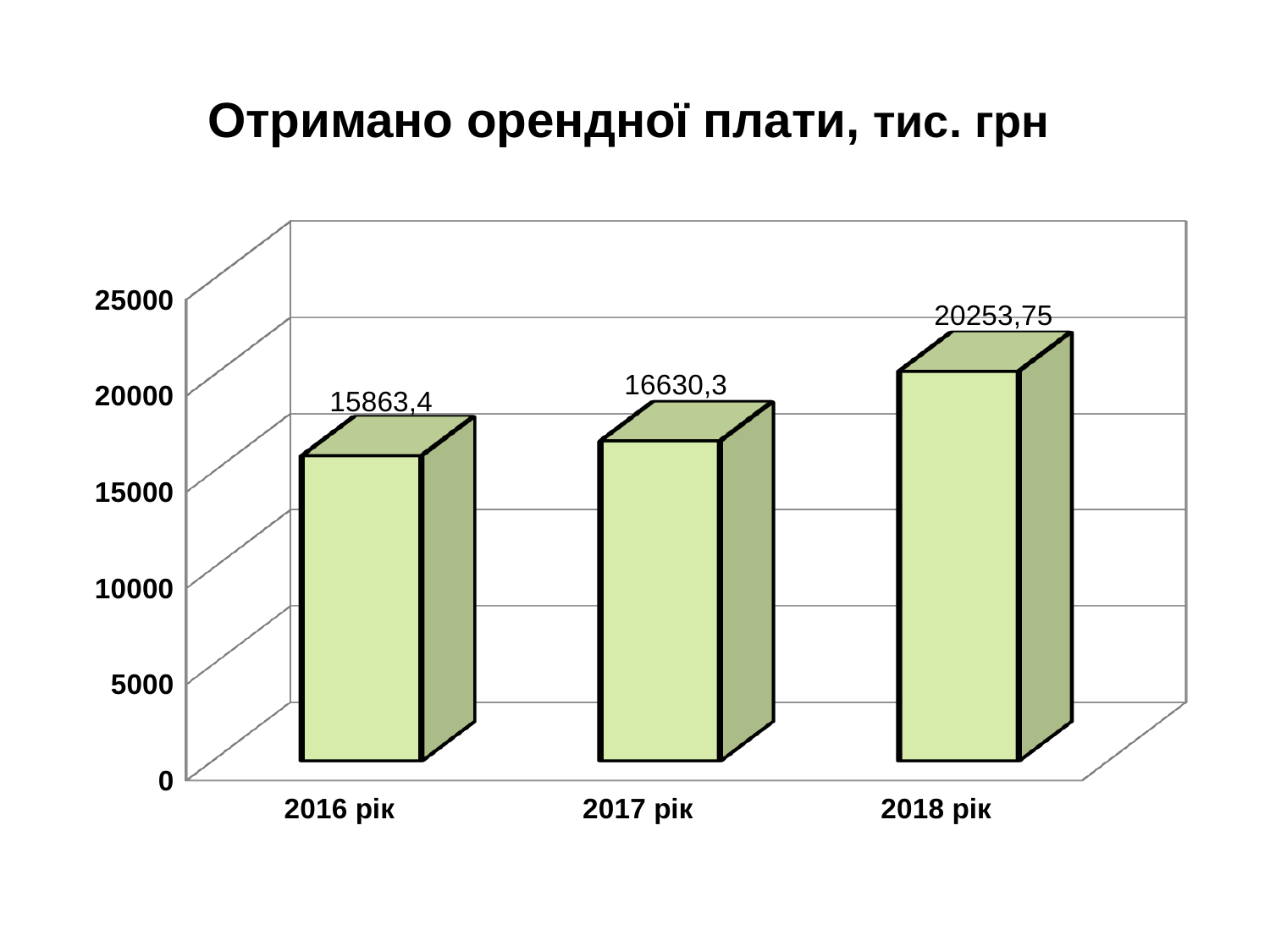
What is the difference between the values for 2017 рік and 2016 рік? 766,9 What value is shown for 2016 рік? 15863,4 Which year has the highest value? 2018 рік Which year has the lowest value? 2016 рік What is the difference between the values for 2018 рік and 2016 рік? 4390,35 Which is larger, the value for 2017 рік or the value for 2018 рік? 2018 рік How many bars are shown in the chart? 3 What value is shown for 2018 рік? 20253,75 What value is shown for 2017 рік? 16630,3 Do the values rise or fall from 2016 рік to 2018 рік? Rise What kind of chart is shown on the slide? Bar chart Is the value for 2018 рік greater or less than 20000? greater